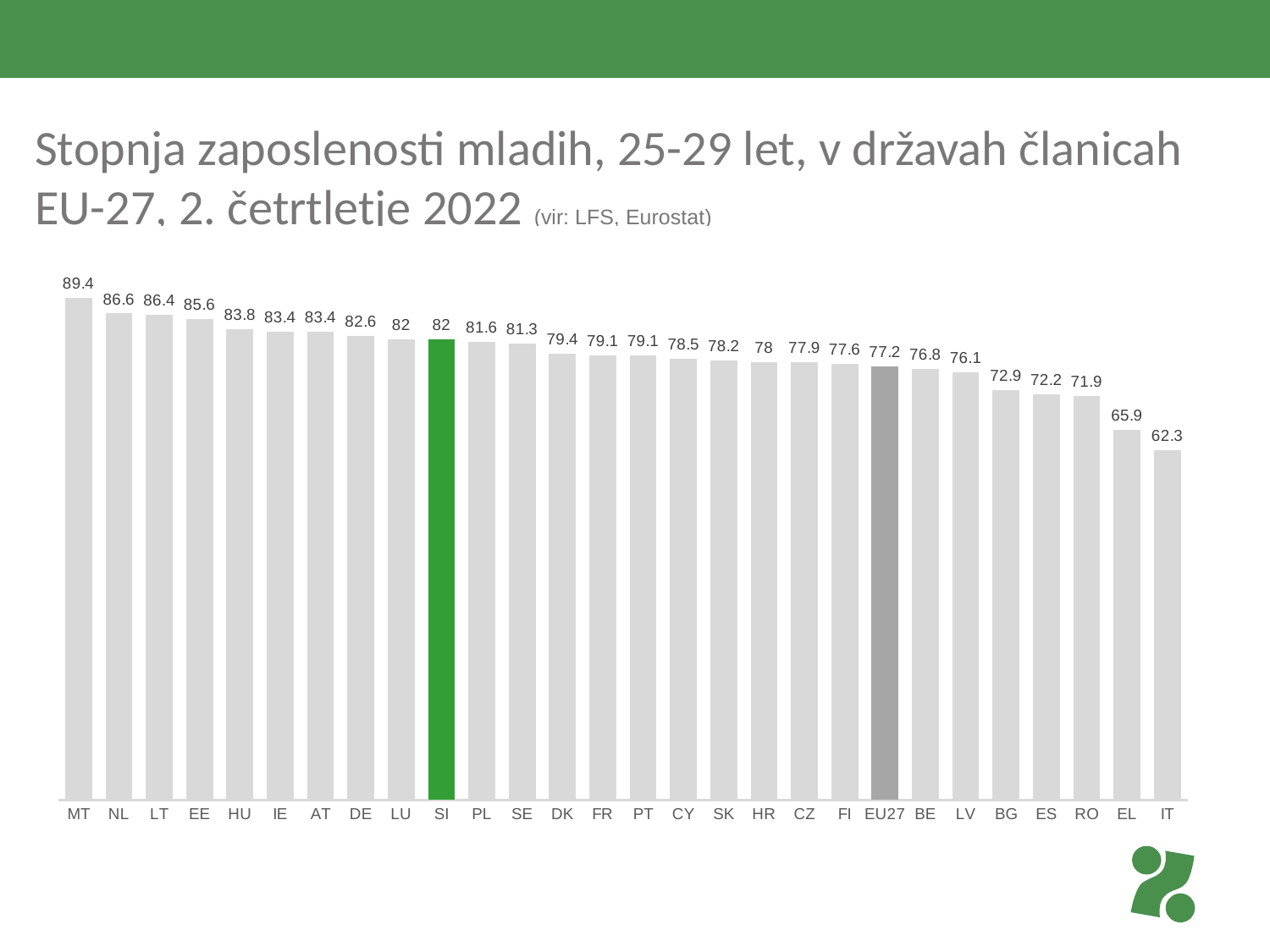
Which has a larger value, BE or LV? BE Which bar is highlighted in green? SI Do the values rise or fall from left to right along the x axis? Fall What is the difference between the values for SI and EU27? 4.8 What is the difference between the values for MT and IT? 27.1 What kind of chart is shown on the slide? Bar chart How many bars are shown in the chart? 28 What is the value for SI? 82 Which category has the lowest value? IT What is the value for DK? 79.4 What is the value for EU27? 77.2 Which category has the highest value? MT